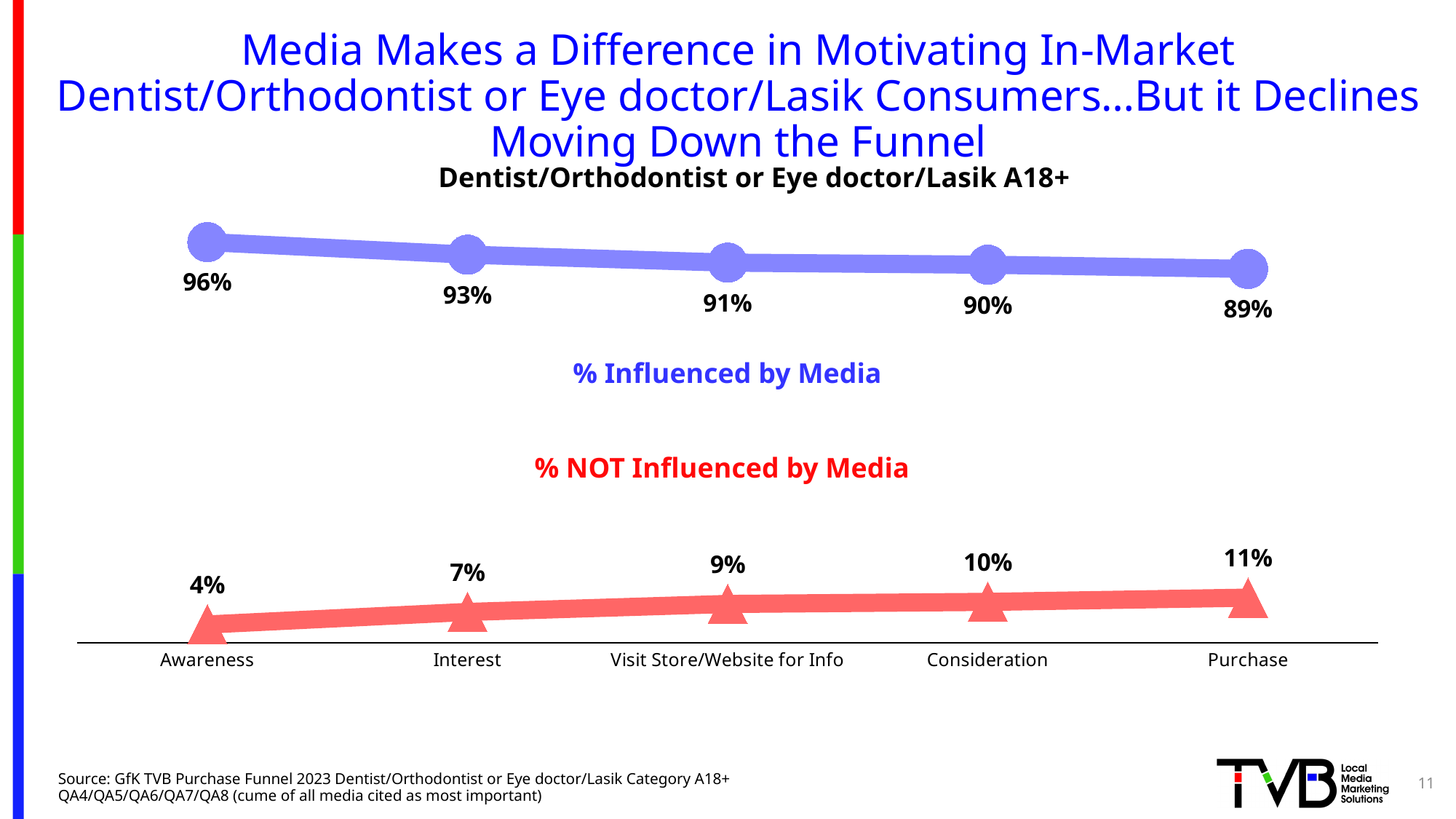
What is the % NOT Influenced by Media value at Visit Store/Website for Info? 9% What type of chart is shown on the slide? Line chart At which funnel stage is the % Influenced by Media lowest? Purchase What is the % Influenced by Media value at the Consideration stage? 90% What is the % Influenced by Media value at the Awareness stage? 96% Does the % Influenced by Media rise or fall moving from Awareness to Purchase? Fall What is the % NOT Influenced by Media value at the Purchase stage? 11% At which funnel stage is the % NOT Influenced by Media highest? Purchase How many funnel stages are shown on the x axis? 5 What is the difference between the % Influenced by Media at Awareness and at Purchase? 7 percentage points How many data series are plotted on the chart? 2 Which is larger: the % NOT Influenced by Media at Interest or at Consideration? Consideration